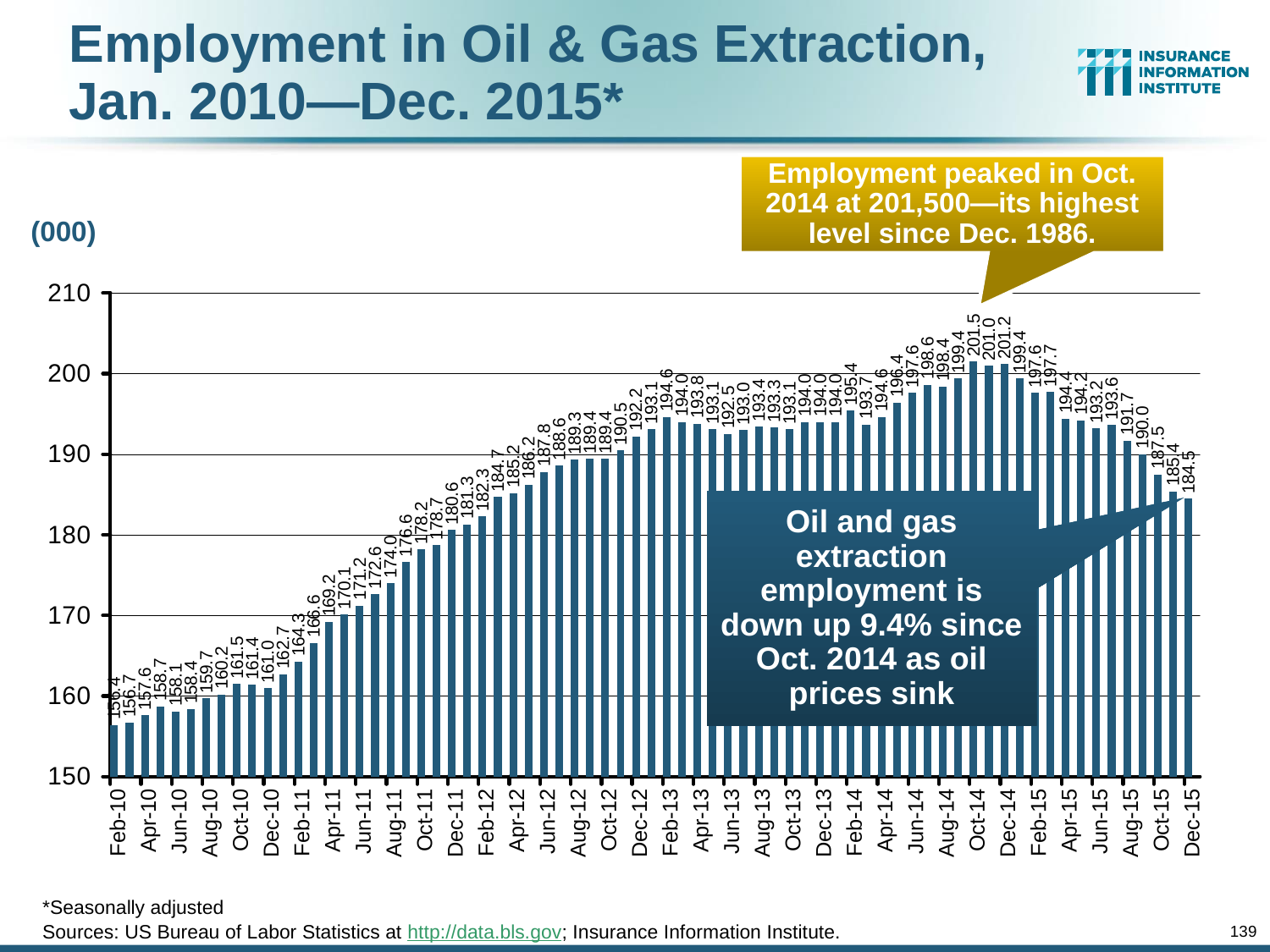
According to the callout, by what percentage is oil and gas extraction employment down since Oct. 2014? 9.4% What kind of chart is shown on the slide? Bar chart What was employment in oil & gas extraction in Feb-10 (in thousands)? 156.4 Which month had higher employment, Oct-14 or Dec-15? Oct-14 What was employment in oil & gas extraction in Oct-15 (in thousands)? 187.5 Is the value for Oct-14 greater or less than 200? greater Is the value for Dec-15 greater or less than 190? less In which month did employment in oil & gas extraction reach its highest level? Oct-14 What was employment in oil & gas extraction in Dec-15 (in thousands)? 184.5 By how much (in thousands) did employment fall from Oct-14 (201.5) to Dec-15 (184.5)? 17.0 What was employment in oil & gas extraction in Oct-14 (in thousands)? 201.5 Do the values rise or fall from Oct-14 to Dec-15? fall